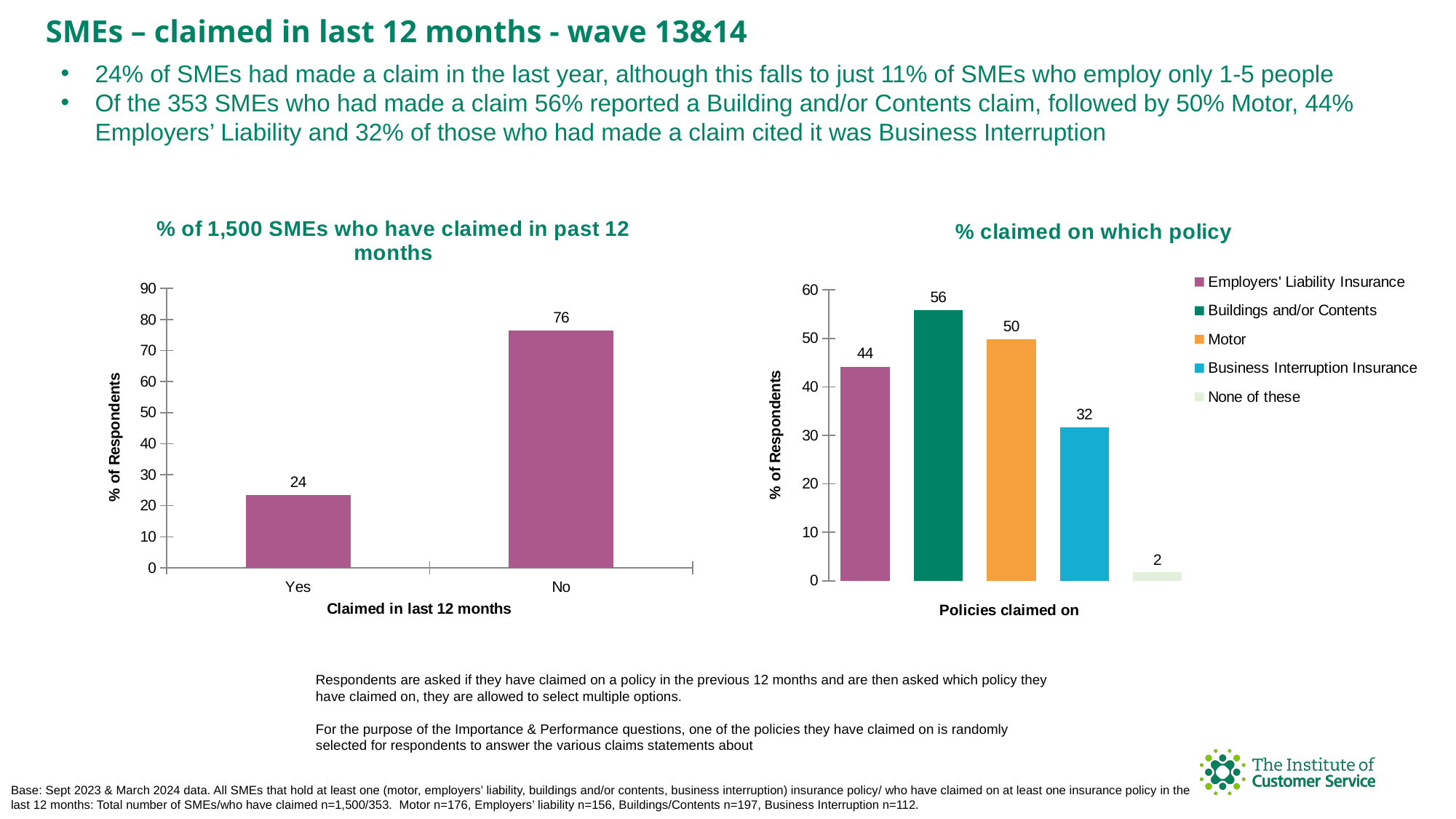
In the '% claimed on which policy' chart, which is larger: Motor or Employers' Liability Insurance? Motor In the '% claimed on which policy' chart, what is the difference between Buildings and/or Contents and Employers' Liability Insurance? 12 In the '% of 1,500 SMEs who have claimed in past 12 months' chart, what is the difference between the 'No' and 'Yes' values? 52 What kind of chart is the '% of 1,500 SMEs who have claimed in past 12 months' chart? Bar chart In the '% claimed on which policy' chart, what is the value for Business Interruption Insurance? 32 How many entries does the legend of the '% claimed on which policy' chart list? 5 In the '% of 1,500 SMEs who have claimed in past 12 months' chart, what is the value for 'Yes'? 24 In the '% claimed on which policy' chart, which category has the lowest value? None of these What is the y-axis label of the '% claimed on which policy' chart? % of Respondents In the '% claimed on which policy' chart, which policy has the highest value? Buildings and/or Contents In the '% claimed on which policy' chart, what is the value for Motor? 50 In the '% of 1,500 SMEs who have claimed in past 12 months' chart, what is the value for 'No'? 76